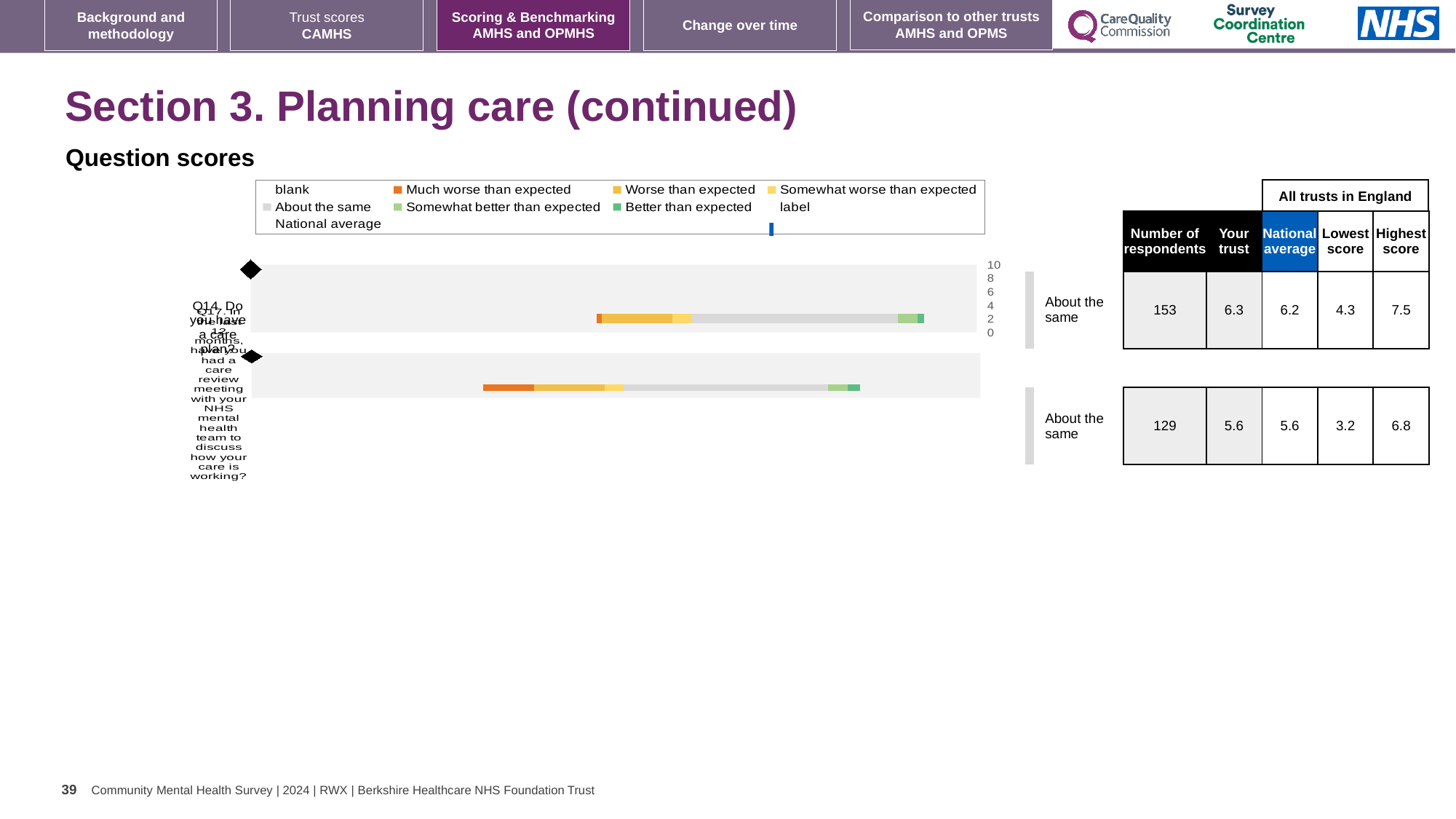
In the chart legend, which category is shown in dark green? Better than expected In the table beside the chart, what is the number of respondents for Q14 (Do you have a care plan?)? 153 What kind of chart is shown under 'Question scores'? bar chart In the chart legend, which category is shown in orange? Much worse than expected What is the difference between the highest and lowest scores for Q14 in the table? 3.2 In the table beside the chart, what is the highest score among all trusts in England for Q14? 7.5 How many questions (bars) are plotted in the chart? 2 In the table beside the chart, what is the national average for Q17 (care review meeting)? 5.6 In the table beside the chart, what is the lowest score among all trusts in England for Q17? 3.2 For Q14, is the 'Your trust' score higher or lower than the national average in the table? higher How many more respondents answered Q14 than Q17 according to the table? 24 In the table beside the chart, what is the 'Your trust' score for Q14? 6.3